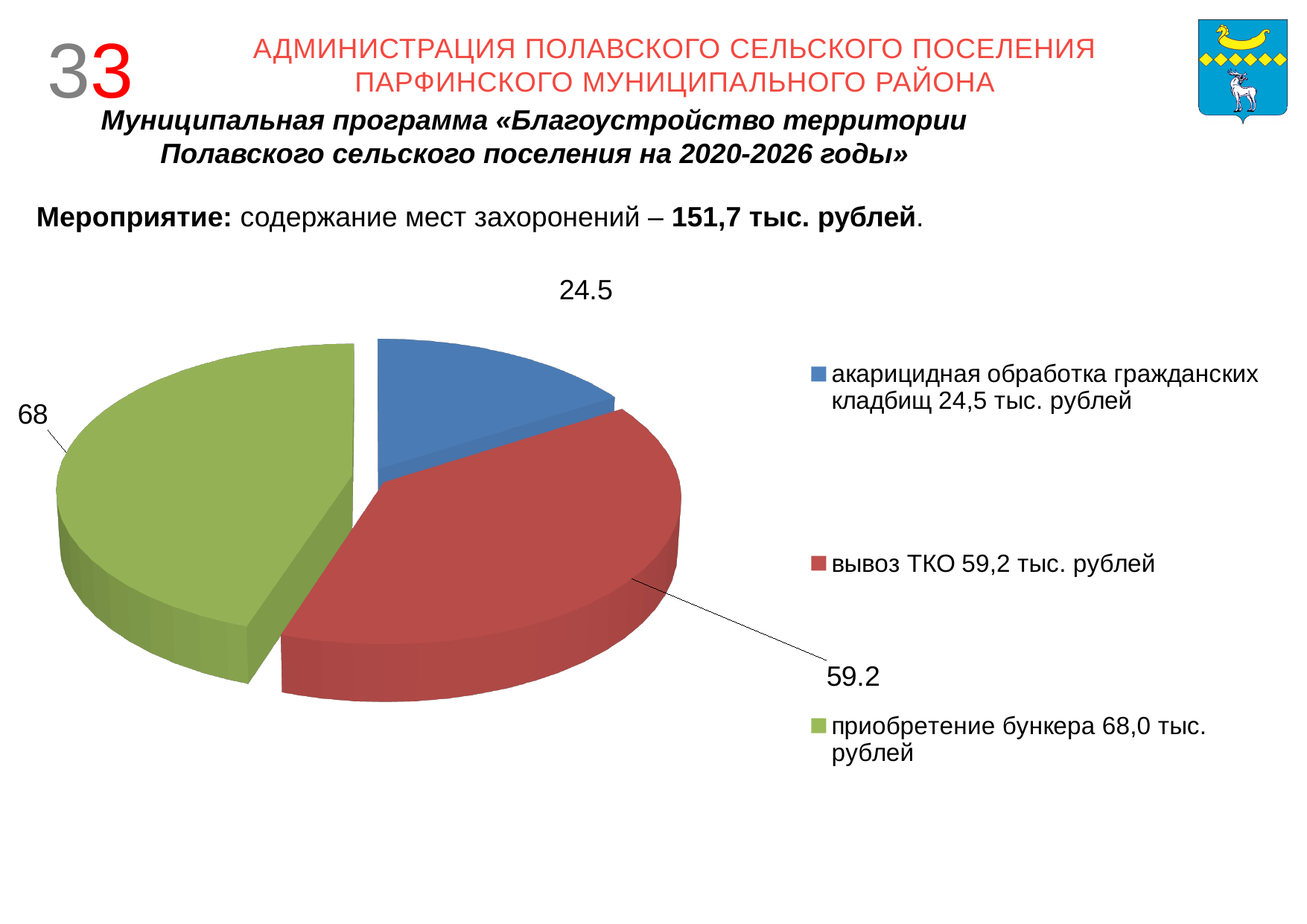
What is the value shown for the slice 'приобретение бункера'? 68 What is the value shown for the slice 'акарицидная обработка гражданских кладбищ'? 24.5 What is the value shown for the slice 'вывоз ТКО'? 59.2 Which slice of the pie chart is the largest? приобретение бункера What is the difference between the values for 'приобретение бункера' and 'акарицидная обработка гражданских кладбищ'? 43.5 Which is larger: the value for 'вывоз ТКО' or the value for 'акарицидная обработка гражданских кладбищ'? вывоз ТКО What type of chart is shown on the slide? pie chart Which slice of the pie chart is the smallest? акарицидная обработка гражданских кладбищ What colour is the slice for 'вывоз ТКО' in the pie chart? red How many entries does the legend of the pie chart list? 3 What is the total of all three slices in the pie chart, in thousand rubles? 151.7 How many slices does the pie chart have? 3